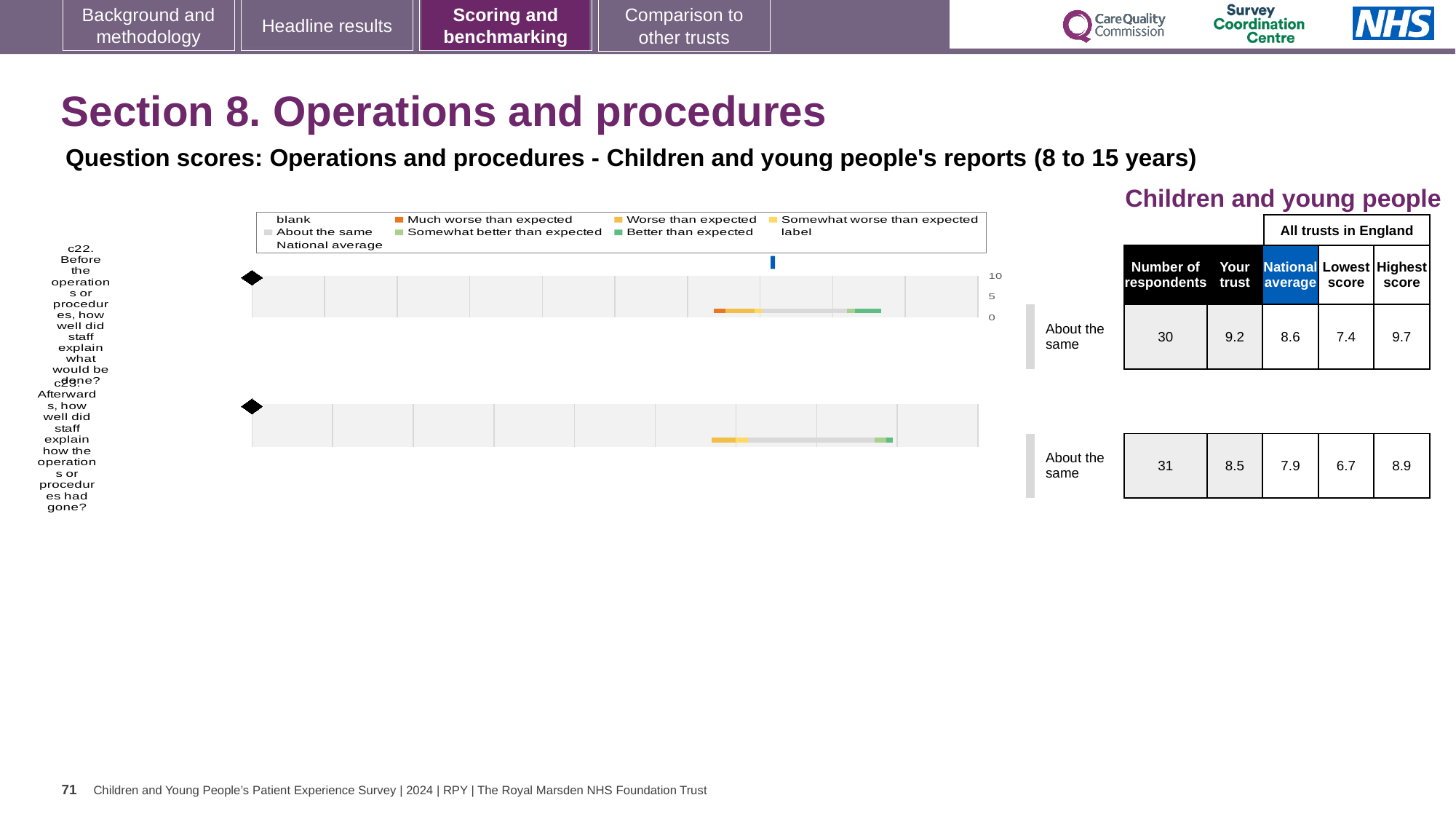
What is the highest score among all trusts in England for question c23? 8.9 Which question has the higher 'Your trust' score, c22 or c23? c22 For question c22 (Before the operations or procedures, how well did staff explain what would be done?), what is the 'Your trust' score? 9.2 What is the lowest score among all trusts in England for question c22? 7.4 For question c23 (Afterwards, how well did staff explain how the operations or procedures had gone?), what is the national average score? 7.9 What benchmark category is shown next to the bar for question c23? About the same How many respondents answered question c22? 30 What is the difference between the 'Your trust' score and the national average for question c23? 0.6 What kind of chart is used to show the benchmarking results for questions c22 and c23? bar chart What is the difference between the 'Your trust' score and the national average for question c22? 0.6 In the legend, what colour represents 'Much worse than expected'? orange How many survey questions (bars) are plotted on the slide? 2